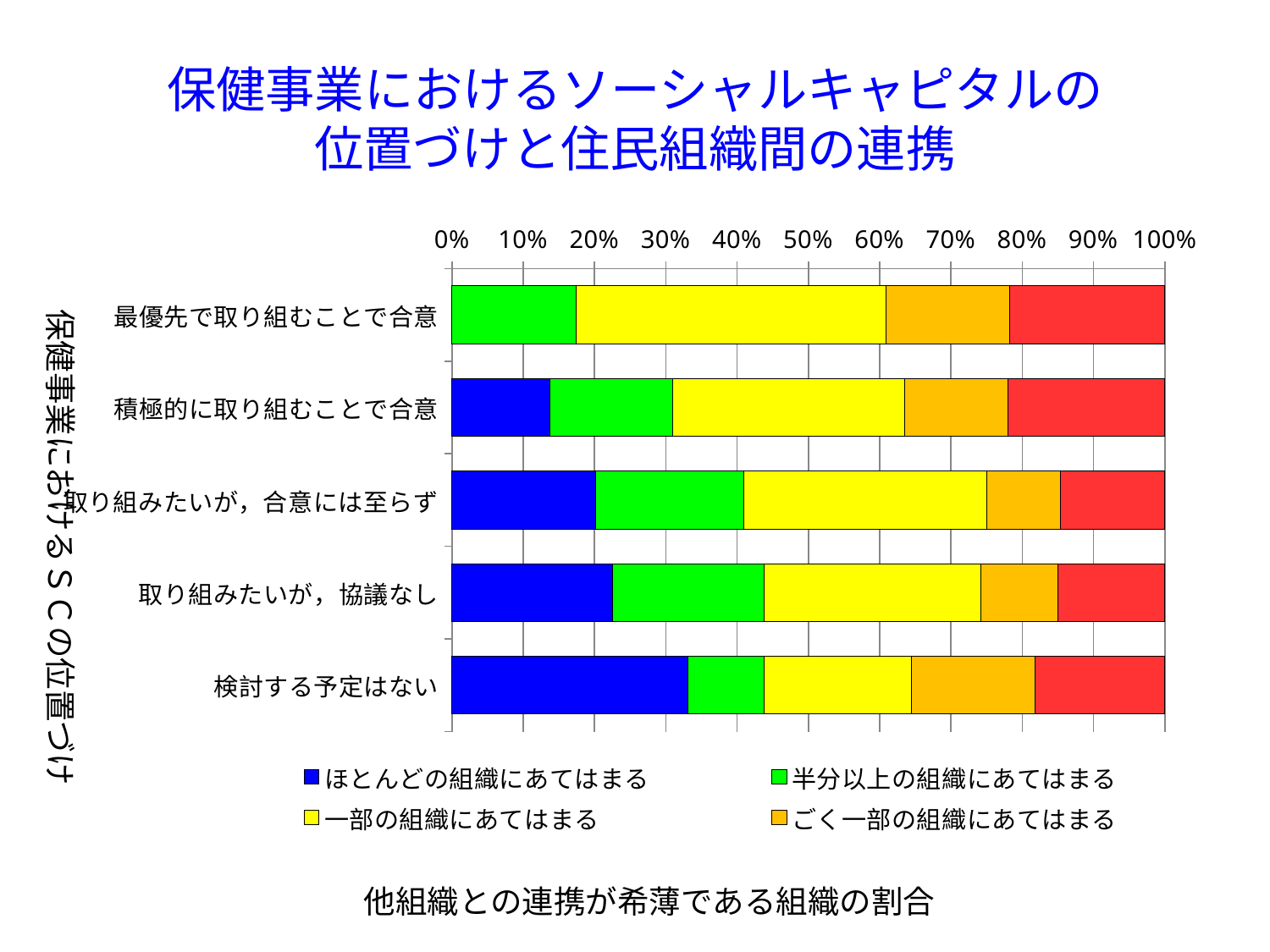
How many series does the chart's legend list? 4 Which has the larger blue (ほとんどの組織にあてはまる) segment: 検討する予定はない or 積極的に取り組むことで合意? 検討する予定はない Moving down the categories from 最優先で取り組むことで合意 to 検討する予定はない, does the blue (ほとんどの組織にあてはまる) segment grow or shrink? grow Which category has no blue (ほとんどの組織にあてはまる) segment at all? 最優先で取り組むことで合意 Which category has the largest blue (ほとんどの組織にあてはまる) segment? 検討する予定はない Is the blue (ほとんどの組織にあてはまる) share for 積極的に取り組むことで合意 greater or less than 20%? less What kind of chart is shown on the slide? Stacked bar chart How many categories are plotted on the vertical axis of the chart? 5 Which category has the largest yellow (一部の組織にあてはまる) segment? 最優先で取り組むことで合意 Which category has the smallest yellow (一部の組織にあてはまる) segment? 検討する予定はない Is the blue (ほとんどの組織にあてはまる) share for 検討する予定はない greater or less than 30%? greater What is the maximum value shown on the horizontal axis of the chart? 100%